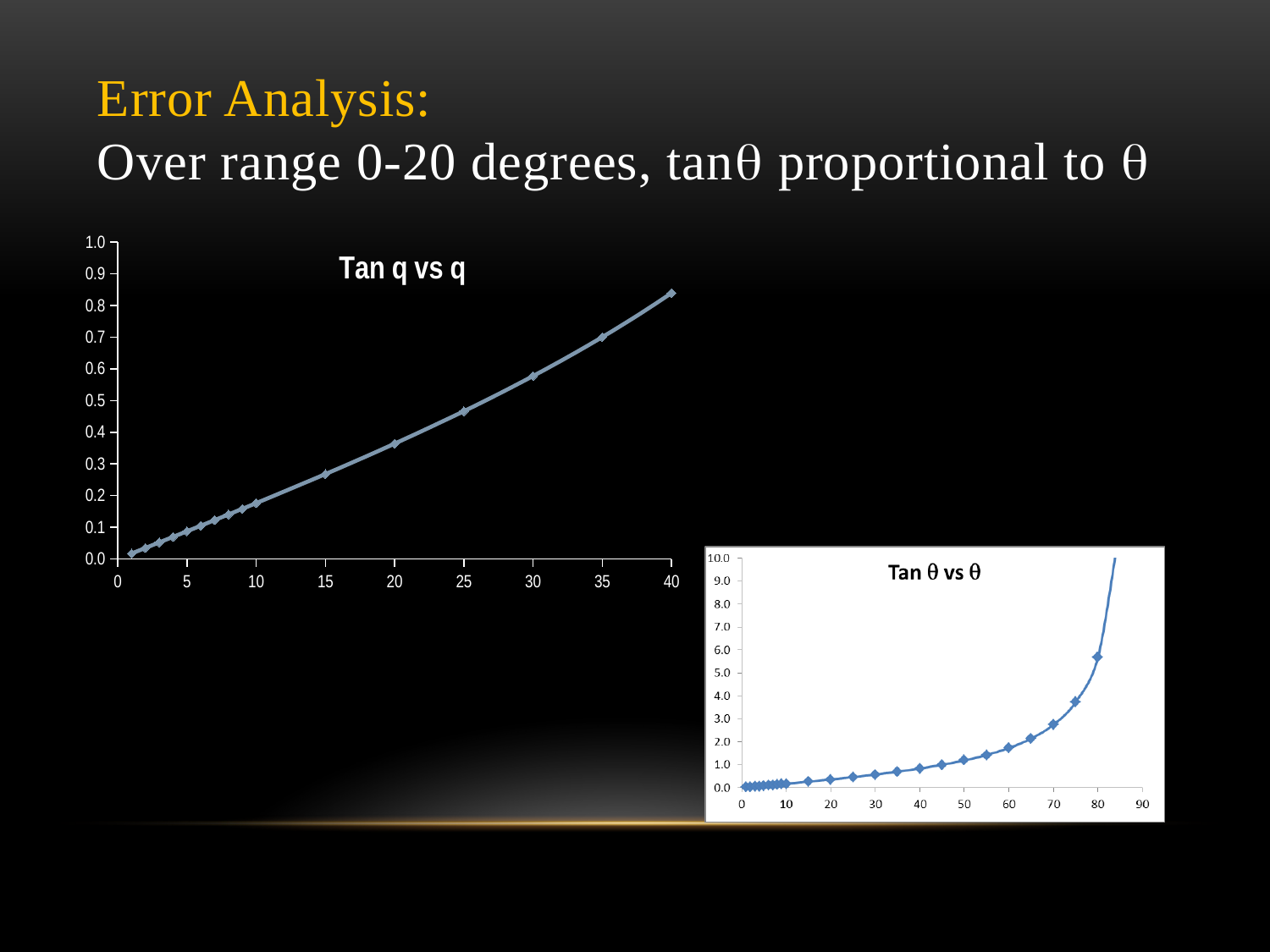
In the left chart 'Tan q vs q', do the values rise or fall as the x axis increases from 0 to 40? rise In the right chart 'Tan θ vs θ', do the values rise or fall as the x axis increases? rise In the left chart 'Tan q vs q', is the value at x = 10 greater or less than 0.2? less In the right chart 'Tan θ vs θ', which has the larger value: x = 80 or x = 70? x = 80 What is the title of the right chart on the slide? Tan θ vs θ In the right chart 'Tan θ vs θ', is the value at x = 30 greater or less than 1.0? less In the left chart 'Tan q vs q', is the value at x = 30 greater or less than 0.5? greater What kind of chart is the left chart titled 'Tan q vs q'? line chart What kind of chart is the right chart titled 'Tan θ vs θ'? line chart In the left chart 'Tan q vs q', which has the larger value: x = 30 or x = 20? x = 30